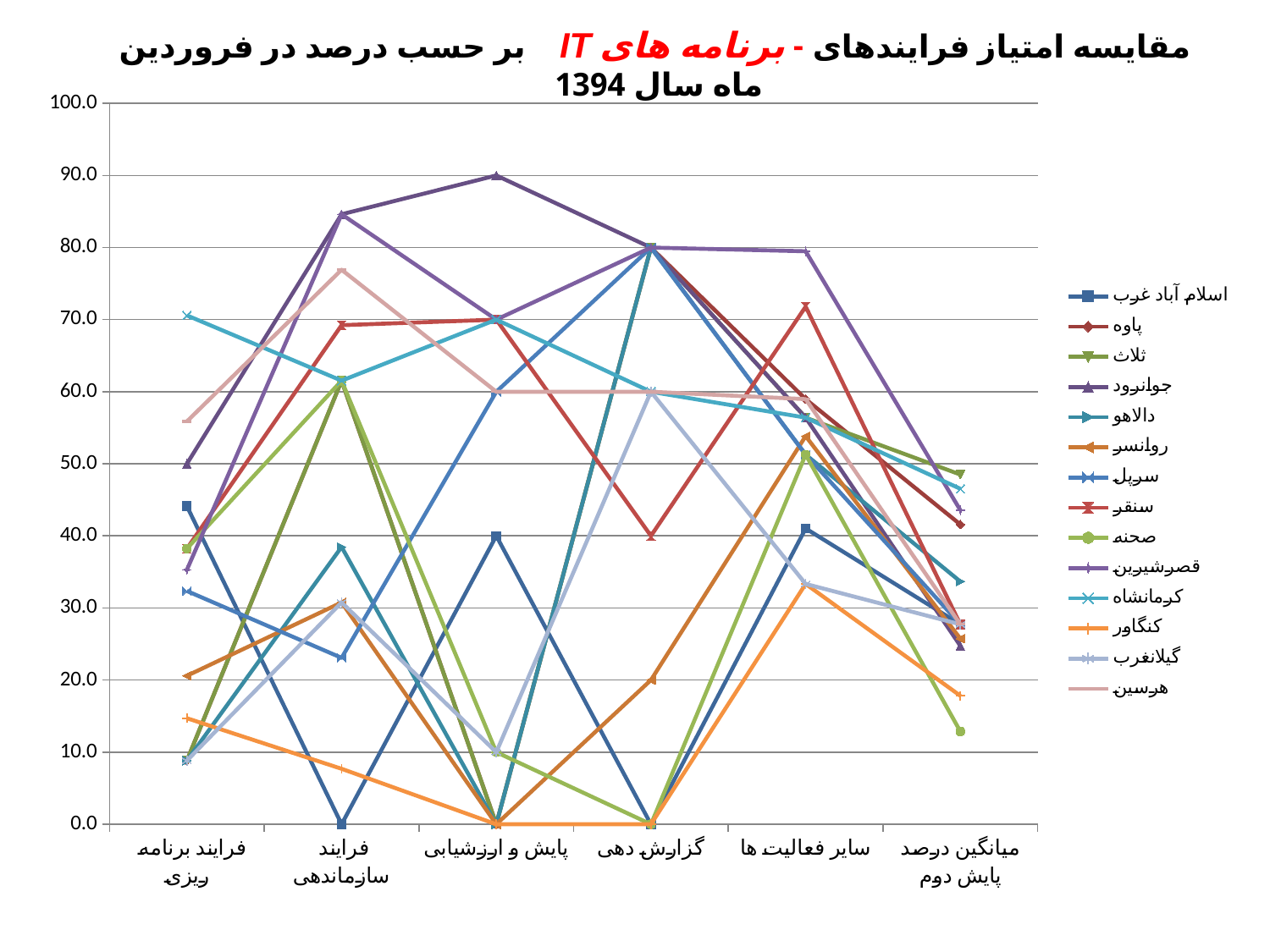
What kind of chart is shown on the slide? line chart Is the value for سنقر at گزارش دهی greater or less than 50.0? less Is the value for هرسین at فرایند سازماندهی greater or less than 70.0? greater Which series has the lowest value at فرایند سازماندهی? اسلام آباد غرب What is the value for اسلام آباد غرب at فرایند سازماندهی? 0.0 What is the value for کنگاور at گزارش دهی? 0.0 Does the value for جوانرود rise or fall from فرایند برنامه ریزی to پایش و ارزشیابی? rise How many categories are shown on the x axis? 6 Which series has the highest value at پایش و ارزشیابی? جوانرود How many series does the legend list? 14 Which series has the highest value at فرایند برنامه ریزی? کرمانشاه At میانگین درصد پایش دوم, which is larger: ثلاث or صحنه? ثلاث